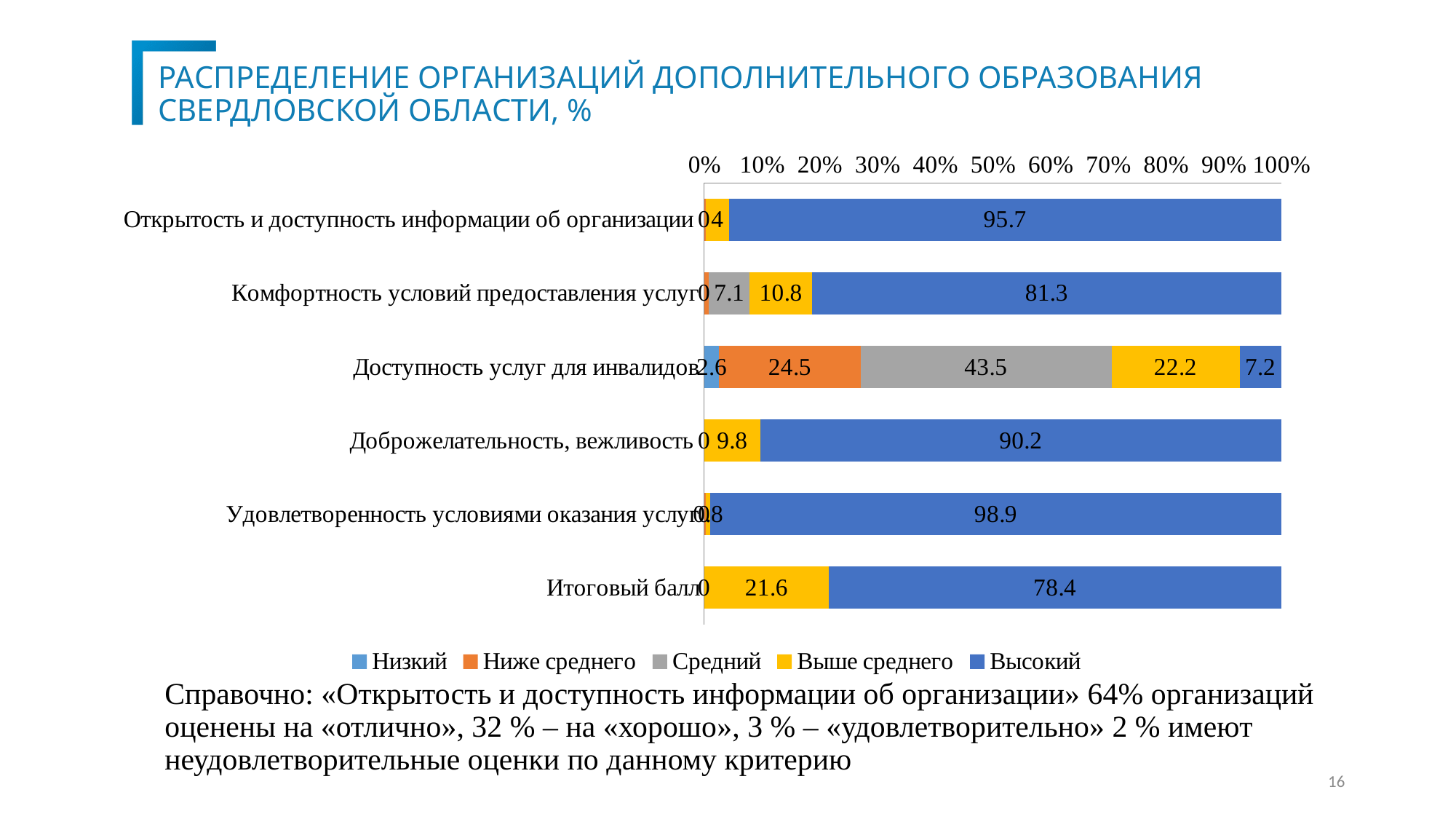
What is the difference between the "Высокий" values for "Доброжелательность, вежливость" and "Итоговый балл"? 11.8 How many series does the legend list? 5 What is the value of the "Высокий" series for "Комфортность условий предоставления услуг"? 81.3 What is the total of the stacked bar for "Доступность услуг для инвалидов"? 100 What is the value of the "Высокий" series for "Доступность услуг для инвалидов"? 7.2 Which is larger: the "Высокий" value for "Открытость и доступность информации об организации" or for "Доброжелательность, вежливость"? Открытость и доступность информации об организации Which category has the highest value for the "Высокий" series? Удовлетворенность условиями оказания услуг Which category has the lowest value for the "Высокий" series? Доступность услуг для инвалидов How many categories are plotted on the chart? 6 What kind of chart is shown on the slide? bar chart What is the value of the "Средний" series for "Доступность услуг для инвалидов"? 43.5 What is the value of the "Выше среднего" series for "Итоговый балл"? 21.6